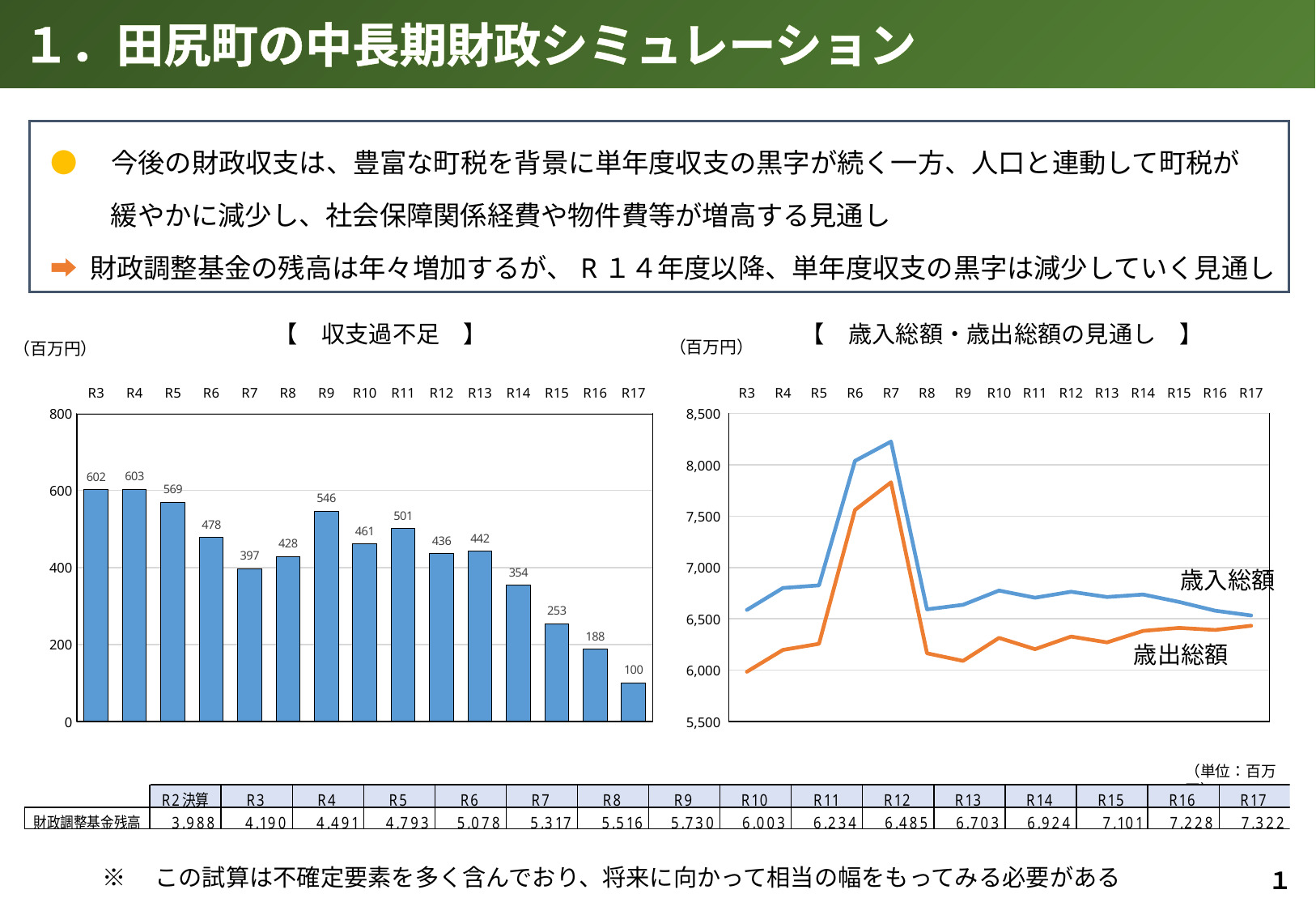
In the 歳入総額・歳出総額の見通し chart, is the value of 歳出総額 at R3 greater or less than 6,500? less In the 収支過不足 chart, which is larger, the value for R9 or the value for R10? R9 In the 歳入総額・歳出総額の見通し chart, is the value of 歳入総額 at R7 greater or less than 8,000? greater In the 収支過不足 chart, what is the difference between the values for R3 and R17? 502 In the 収支過不足 chart, how many years are plotted? 15 What unit is shown for the values in the 収支過不足 chart? 百万円 In the 収支過不足 chart, what is the value for R17? 100 What kind of chart is the 収支過不足 chart? bar chart In the 収支過不足 chart, which year has the lowest value? R17 How many series are plotted in the 歳入総額・歳出総額の見通し chart? 2 In the 収支過不足 chart, what is the value for R9? 546 In the 収支過不足 chart, do the values rise or fall from R12 to R17? fall